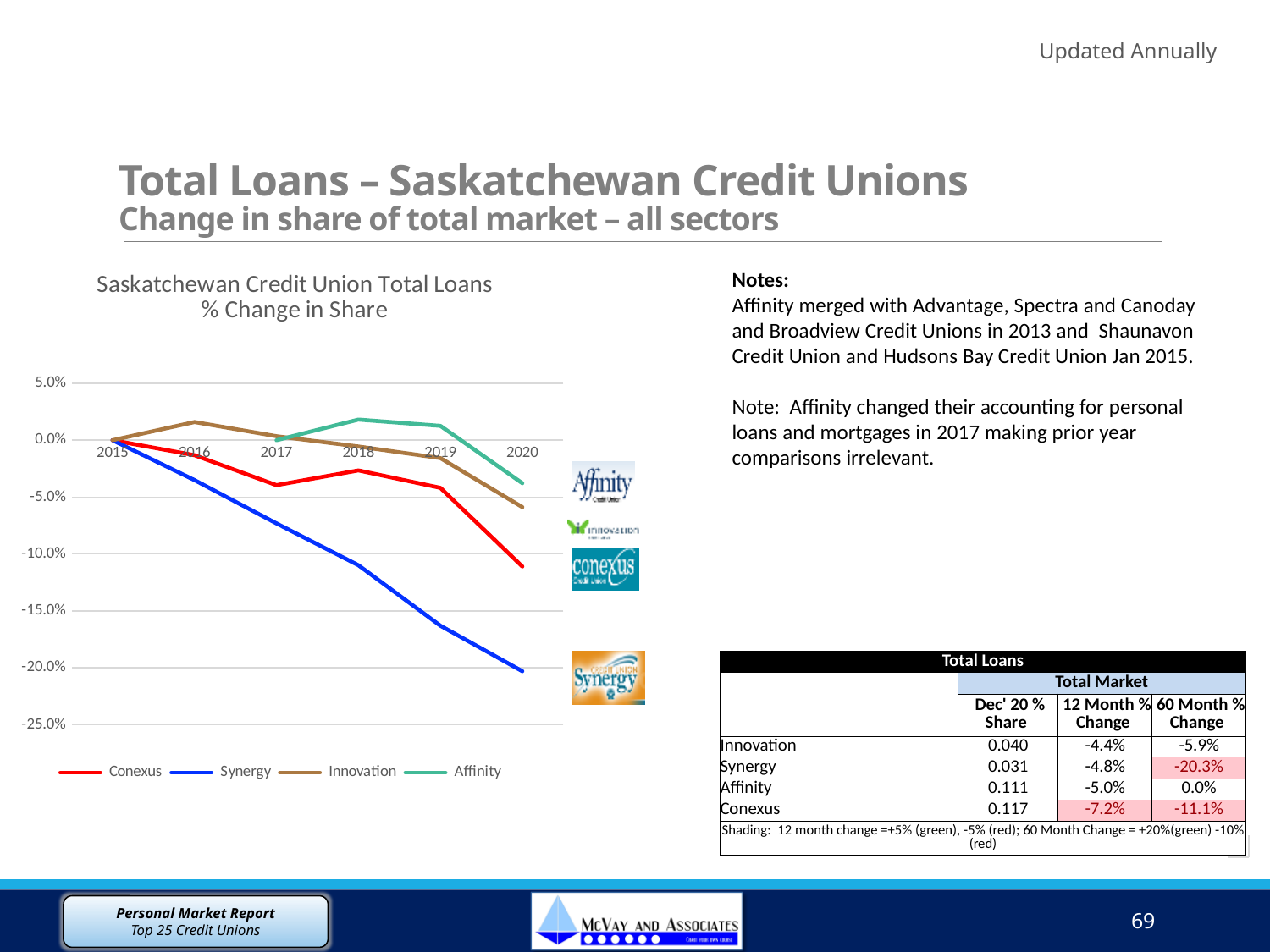
In 2020, which is higher: Innovation or Synergy? Innovation How many series does the chart legend list? 4 Does the Synergy line rise or fall from 2015 to 2020? fall Which series has the highest value in 2020? Affinity Is the value for Synergy in 2020 greater or less than -15.0%? less Is the value for Innovation in 2020 greater or less than -10.0%? greater Is the value for Conexus in 2020 greater or less than -5.0%? less Which series has the lowest value in 2020? Synergy How many years are shown along the x axis of the chart? 6 What is the title of the chart? Saskatchewan Credit Union Total Loans % Change in Share What kind of chart is shown on the slide? line chart